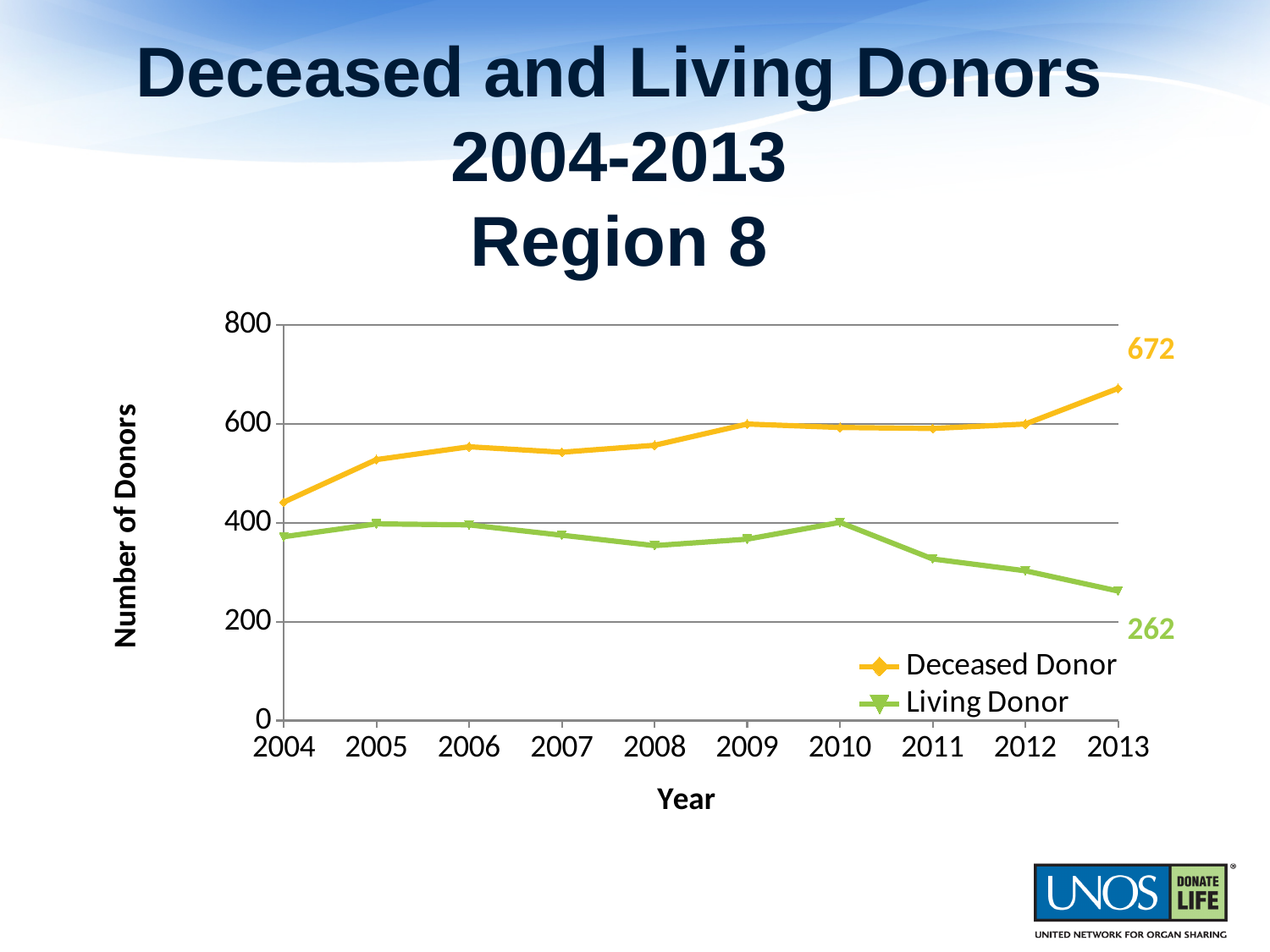
What is the value for Deceased Donor in 2013? 672 Is the value for Deceased Donor in 2004 greater or less than 400? greater What is the difference between the Deceased Donor and Living Donor values in 2013? 410 What is the label on the y axis? Number of Donors In 2013, which series has the larger value, Deceased Donor or Living Donor? Deceased Donor How many years are plotted on the x axis? 10 What type of chart is shown on the slide? Line chart In which year is the Deceased Donor value highest? 2013 How many series does the legend list? 2 Does the Living Donor line rise or fall overall from 2004 to 2013? Fall Is the value for Living Donor in 2008 greater or less than 400? less What is the value for Living Donor in 2013? 262